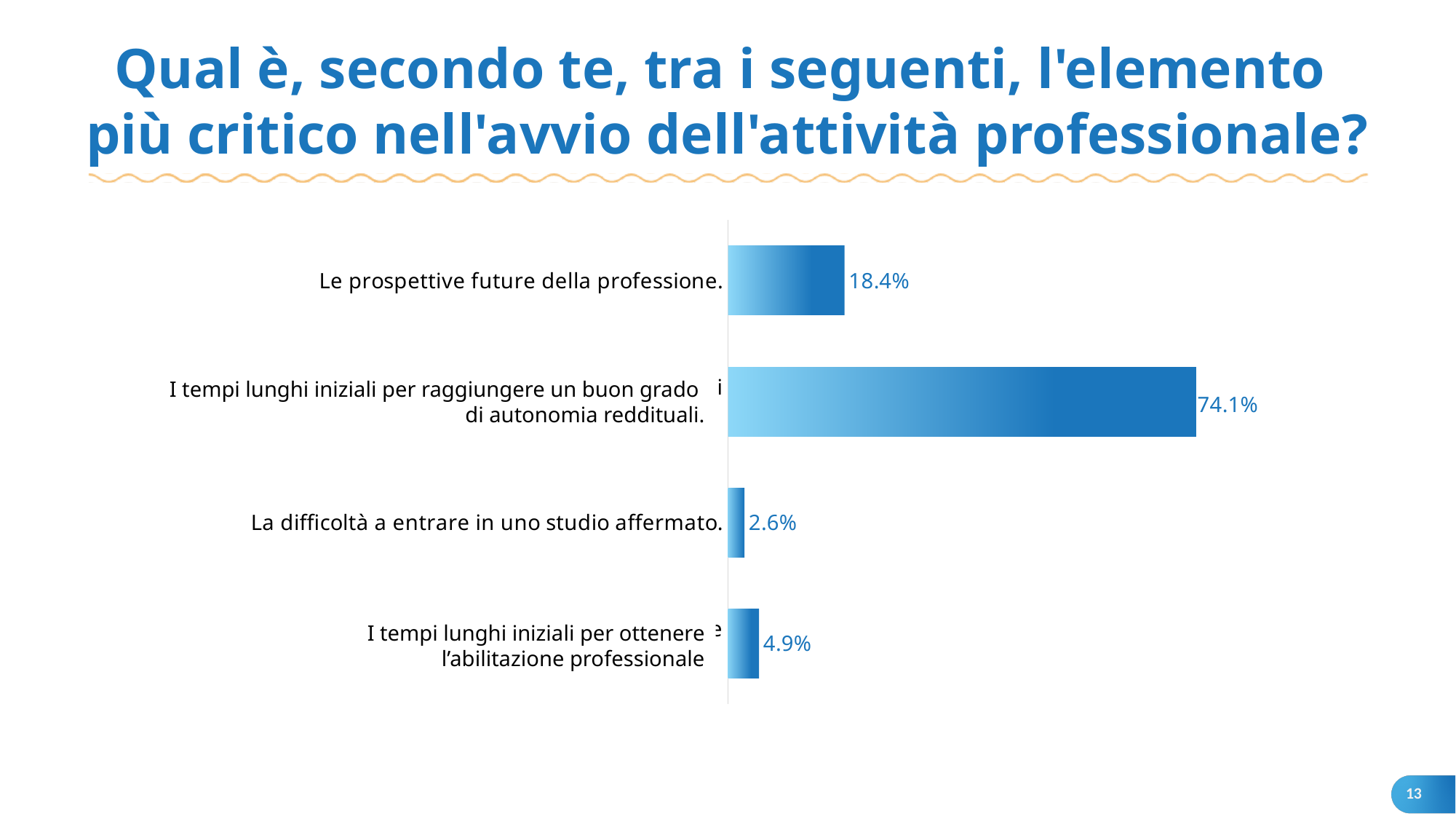
What is the difference between the values for "I tempi lunghi iniziali per raggiungere un buon grado di autonomia reddituali" and "Le prospettive future della professione"? 55.7% Which category has the lowest value? La difficoltà a entrare in uno studio affermato What is the value for "I tempi lunghi iniziali per raggiungere un buon grado di autonomia reddituali"? 74.1% What kind of chart is shown on the slide? Bar chart What is the value for "Le prospettive future della professione"? 18.4% What is the value for "I tempi lunghi iniziali per ottenere l'abilitazione professionale"? 4.9% What is the title of the slide containing the chart? Qual è, secondo te, tra i seguenti, l'elemento più critico nell'avvio dell'attività professionale? What is the value for "La difficoltà a entrare in uno studio affermato"? 2.6% Which category has the highest value? I tempi lunghi iniziali per raggiungere un buon grado di autonomia reddituali Which is larger: the value for "Le prospettive future della professione" or the value for "I tempi lunghi iniziali per ottenere l'abilitazione professionale"? Le prospettive future della professione How many categories are shown in the chart? 4 What is the difference between the values for "I tempi lunghi iniziali per ottenere l'abilitazione professionale" and "La difficoltà a entrare in uno studio affermato"? 2.3%